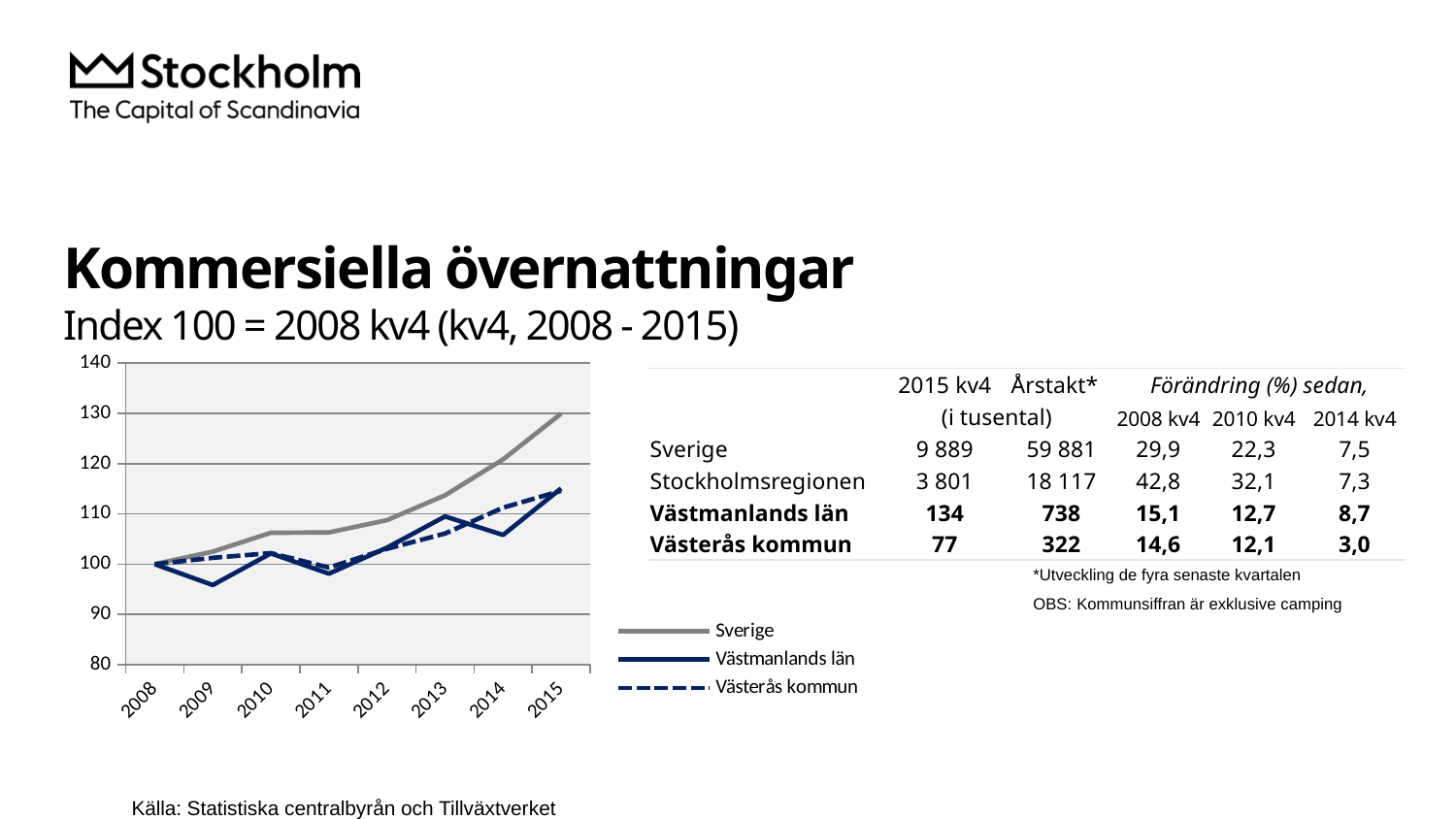
Is the value for Västmanlands län in 2009 greater or less than 100? less How many years are shown along the x axis of the chart? 8 Is the value for Västerås kommun in 2015 greater or less than 110? greater In 2014, which is larger: the value for Sverige or the value for Västmanlands län? Sverige Which series has the highest value in 2015? Sverige Which series is drawn with a dashed line? Västerås kommun Which series has the lowest value in 2009? Västmanlands län What is the index value of the series in 2008, the base year? 100 How many series does the chart legend list? 3 Does the Sverige series rise or fall from 2008 to 2015? rises What kind of chart is shown on the slide? line chart Is the value for Sverige in 2015 greater or less than 120? greater